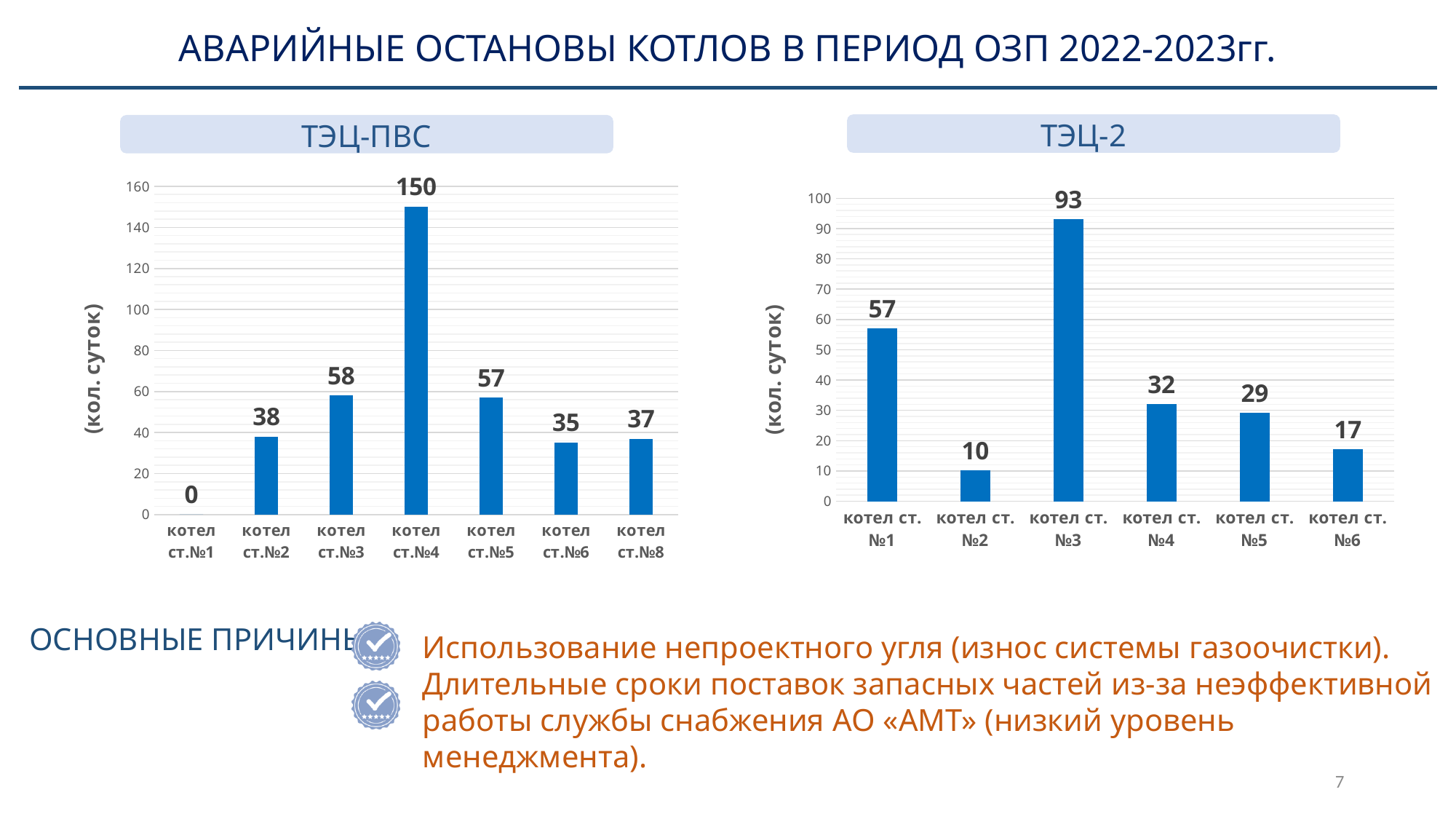
In the ТЭЦ-2 chart, which boiler has the highest value? котел ст. №3 In the ТЭЦ-ПВС chart, what is the value for котел ст.№1? 0 How many boilers are shown in the ТЭЦ-ПВС chart? 7 What type of chart is the ТЭЦ-2 chart? Bar chart In the ТЭЦ-ПВС chart, which is larger: котел ст.№2 or котел ст.№6? котел ст.№2 In the ТЭЦ-2 chart, which boiler has the lowest value? котел ст. №2 In the ТЭЦ-ПВС chart, what is the value for котел ст.№4? 150 How many boilers are shown in the ТЭЦ-2 chart? 6 In the ТЭЦ-2 chart, what is the value for котел ст. №5? 29 What is the y-axis label of the ТЭЦ-ПВС chart? (кол. суток) In the ТЭЦ-2 chart, what is the difference between котел ст. №1 and котел ст. №4? 25 In the ТЭЦ-ПВС chart, what is the difference between котел ст.№4 and котел ст.№3? 92